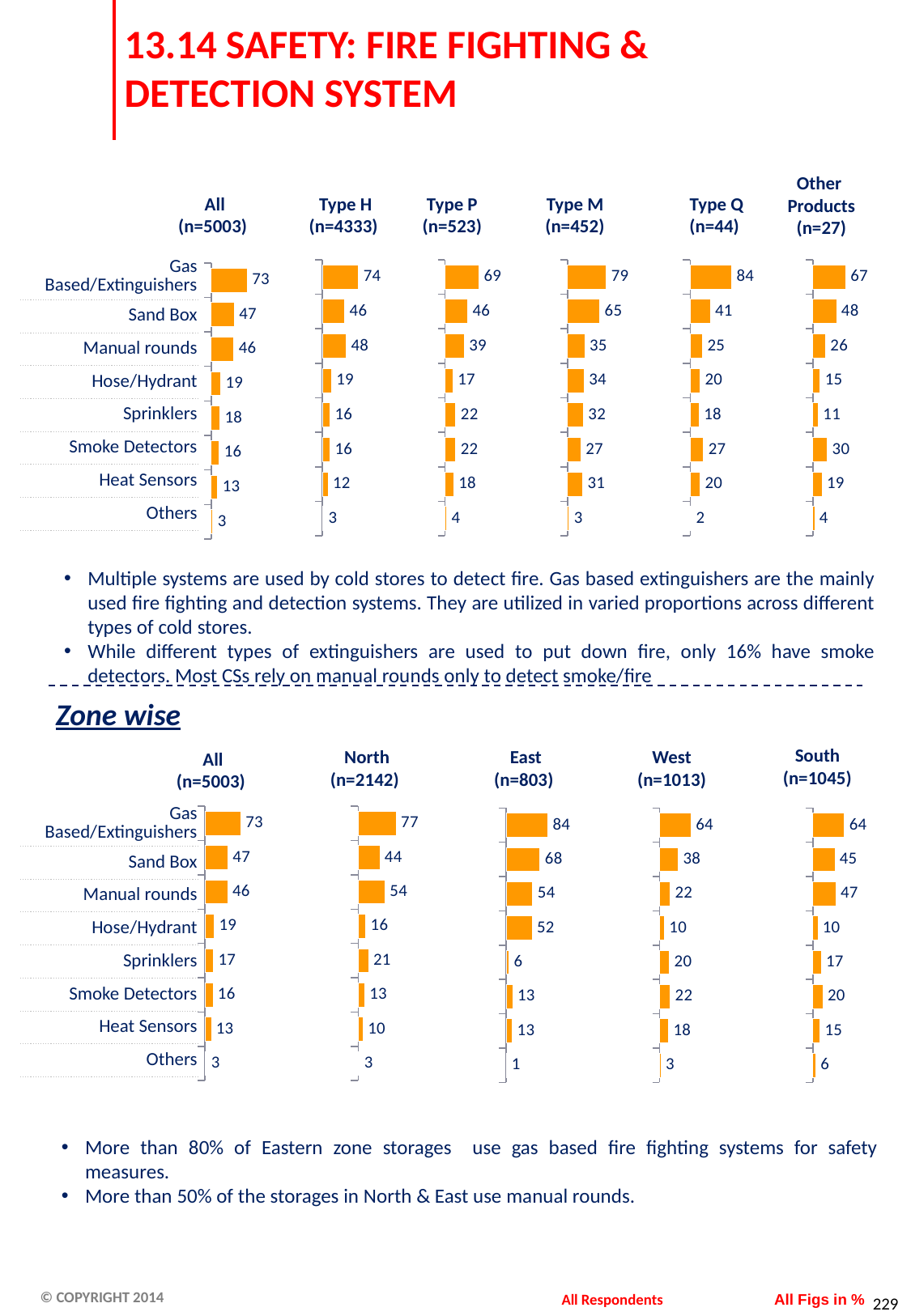
For Sprinklers, which top-row chart shows the larger value, "Type H (n=4333)" or "Type P (n=523)"? Type P (n=523) In the top row "Other Products (n=27)" chart, what is the value for Smoke Detectors? 30 In the Zone wise "East (n=803)" chart, what is the value for Hose/Hydrant? 52 In the Zone wise "North (n=2142)" chart, which is larger, Manual rounds or Sand Box? Manual rounds In the top row "All (n=5003)" chart, what is the difference between the values for Gas Based/Extinguishers and Sand Box? 26 How many categories are listed in the Zone wise "South (n=1045)" chart? 8 What kind of chart is used in the "All (n=5003)" chart at the top of the slide? Bar chart In the Zone wise "West (n=1013)" chart, what is the difference between Smoke Detectors and Heat Sensors? 4 In the top row of charts, what is the value for Sand Box in the "Type M (n=452)" chart? 65 In the Zone wise "East (n=803)" chart, which category has the lowest value? Others How many separate charts are shown in the Zone wise section? 5 In the top row "Type Q (n=44)" chart, which category has the highest value? Gas Based/Extinguishers